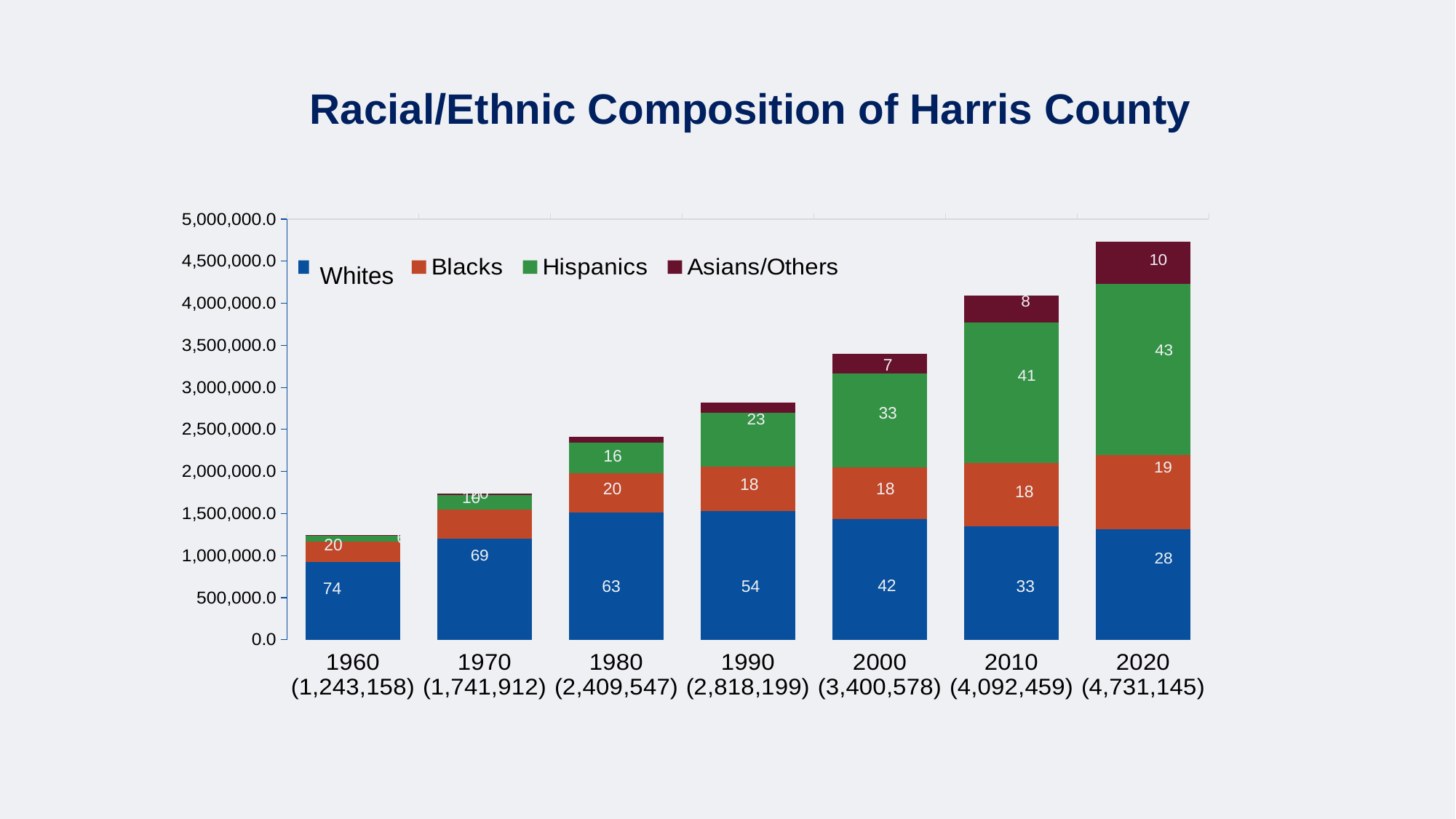
In 1990, which has the larger data label, Whites or Hispanics? Whites What kind of chart is shown on the slide? Stacked bar chart Is the total height of the 2000 bar greater or less than 3,000,000? greater What total population is printed under the 2020 bar? 4,731,145 What is the difference between the Whites data label in 1960 and in 2020? 46 How many series does the legend list? 4 What is the data label for Hispanics in 2020? 43 What is the data label for Whites in 1960? 74 What is the data label for Blacks in 1980? 20 How many years (bars) are shown on the x axis? 7 Do the Whites data labels rise or fall from 1960 to 2020? Fall What is the data label for Asians/Others in 2010? 8